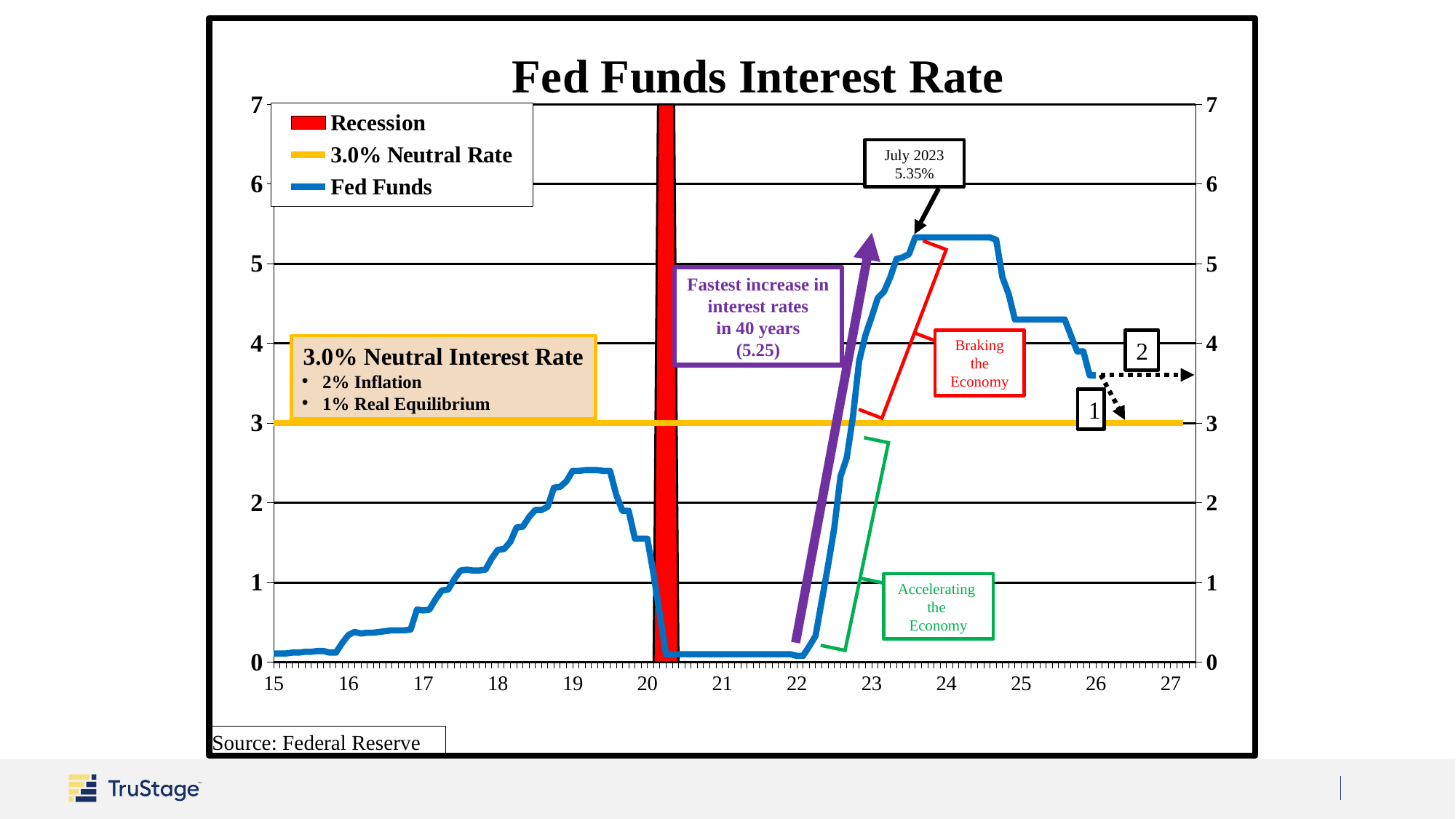
Is the Fed Funds rate at the start of 2025 greater or less than 4? greater Does the Fed Funds rate rise or fall between 2024 and 2026? fall Is the Fed Funds rate at the start of 2021 greater or less than 1? less Does the Fed Funds rate rise or fall between 2022 and 2023? rise Which is higher, the Fed Funds rate at the start of 2019 or at the start of 2024? 2024 Is the Fed Funds rate at the start of 2019 greater or less than 2? greater What kind of chart is used to show the Fed Funds rate? line chart What colour is the Recession series in the legend? red What is the title of the chart? Fed Funds Interest Rate What Fed Funds rate is labelled for July 2023? 5.35% What is the value of the neutral interest rate line? 3.0% How many entries does the legend list? 3